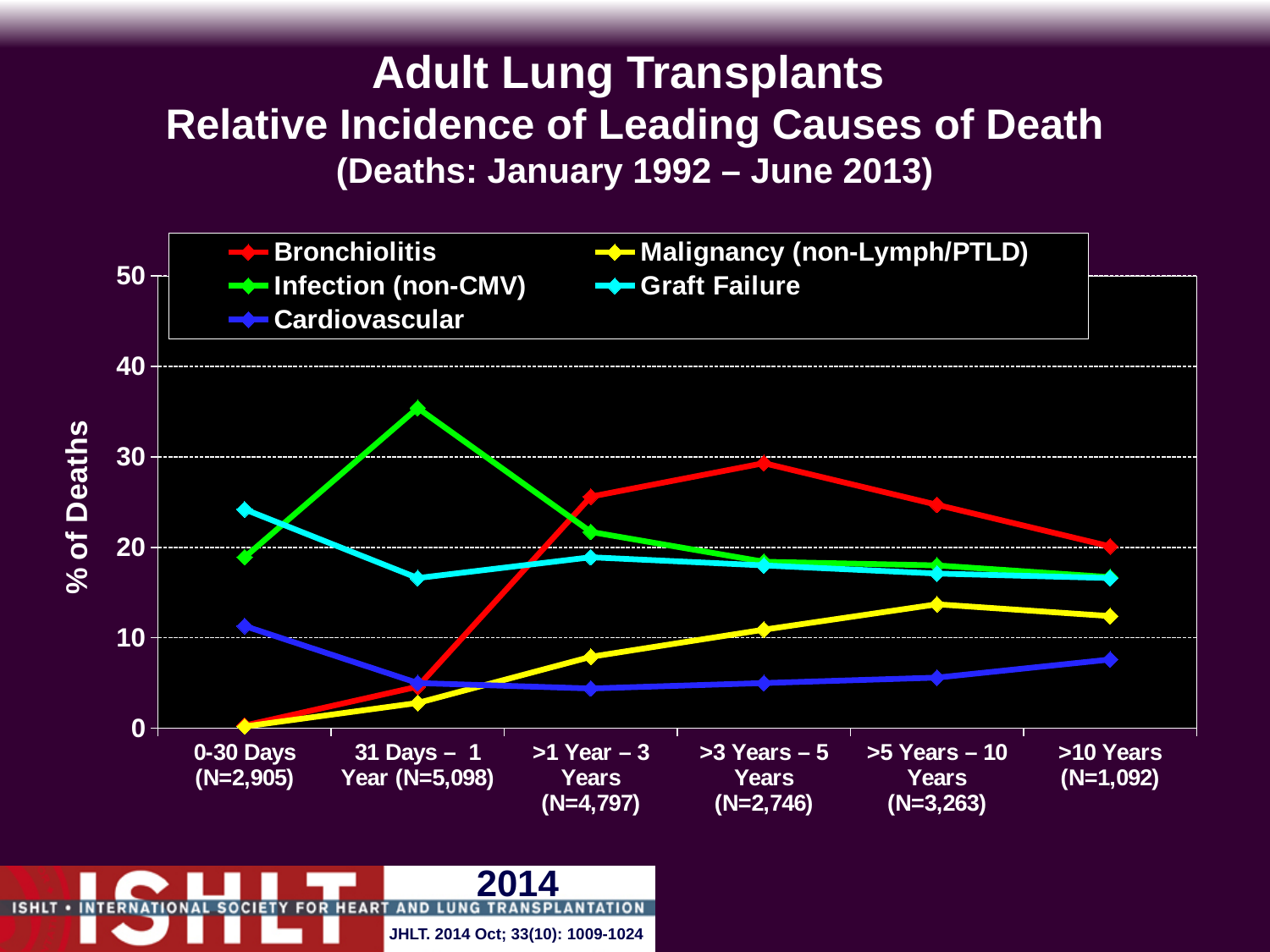
In the 0-30 Days period, which is larger: Graft Failure or Infection (non-CMV)? Graft Failure How many time-period categories are shown on the x axis? 6 Does the Malignancy (non-Lymph/PTLD) line rise or fall from 0-30 Days to >5 Years – 10 Years? Rises Which cause of death has the highest % of deaths in the 31 Days – 1 Year period? Infection (non-CMV) Is the value for Bronchiolitis in the >3 Years – 5 Years period greater or less than 20? greater Is the value for Infection (non-CMV) in the 31 Days – 1 Year period greater or less than 30? greater In which time period does Bronchiolitis reach its highest % of deaths? >3 Years – 5 Years How many series does the legend list? 5 Which cause of death has the lowest % of deaths in the >10 Years period? Cardiovascular What is the label on the y axis? % of Deaths Is the value for Bronchiolitis in the 0-30 Days period greater or less than 10? less What kind of chart is shown on the slide? Line chart